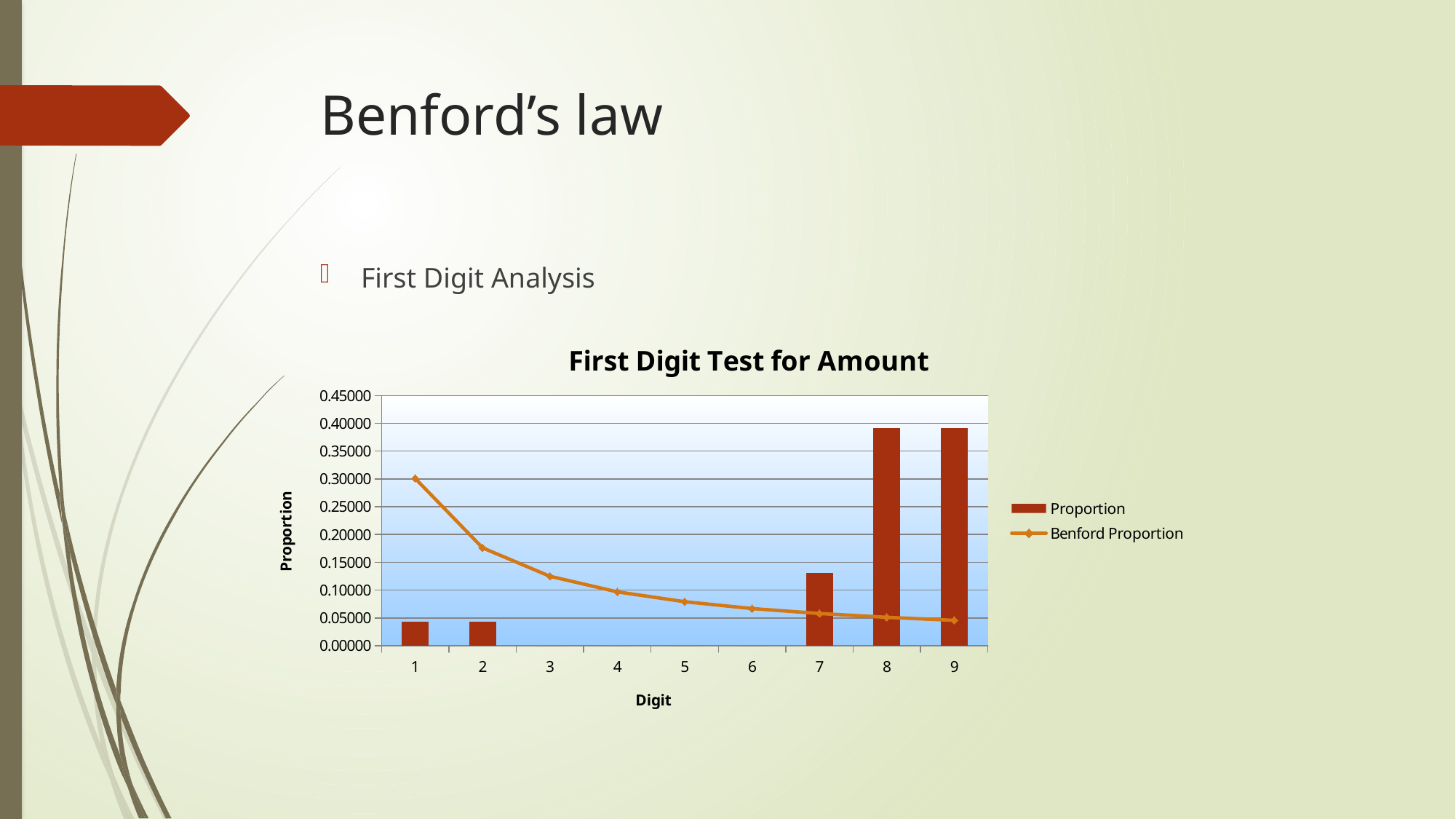
Is the Proportion value for digit 7 greater or less than 0.10? greater Does the Benford Proportion line rise or fall as the digit increases from 1 to 9? Fall For digit 2, which is larger: the Proportion bar or the Benford Proportion line? Benford Proportion What is the title of the chart? First Digit Test for Amount Which series is drawn as a line in the chart? Benford Proportion Is the Proportion value for digit 8 greater or less than 0.35? greater Which digit has the highest Benford Proportion? 1 What kind of chart is shown on the slide? Combined bar and line chart How many digit categories are shown on the x axis? 9 Is the Benford Proportion value for digit 5 greater or less than 0.10? less How many series does the chart legend list? 2